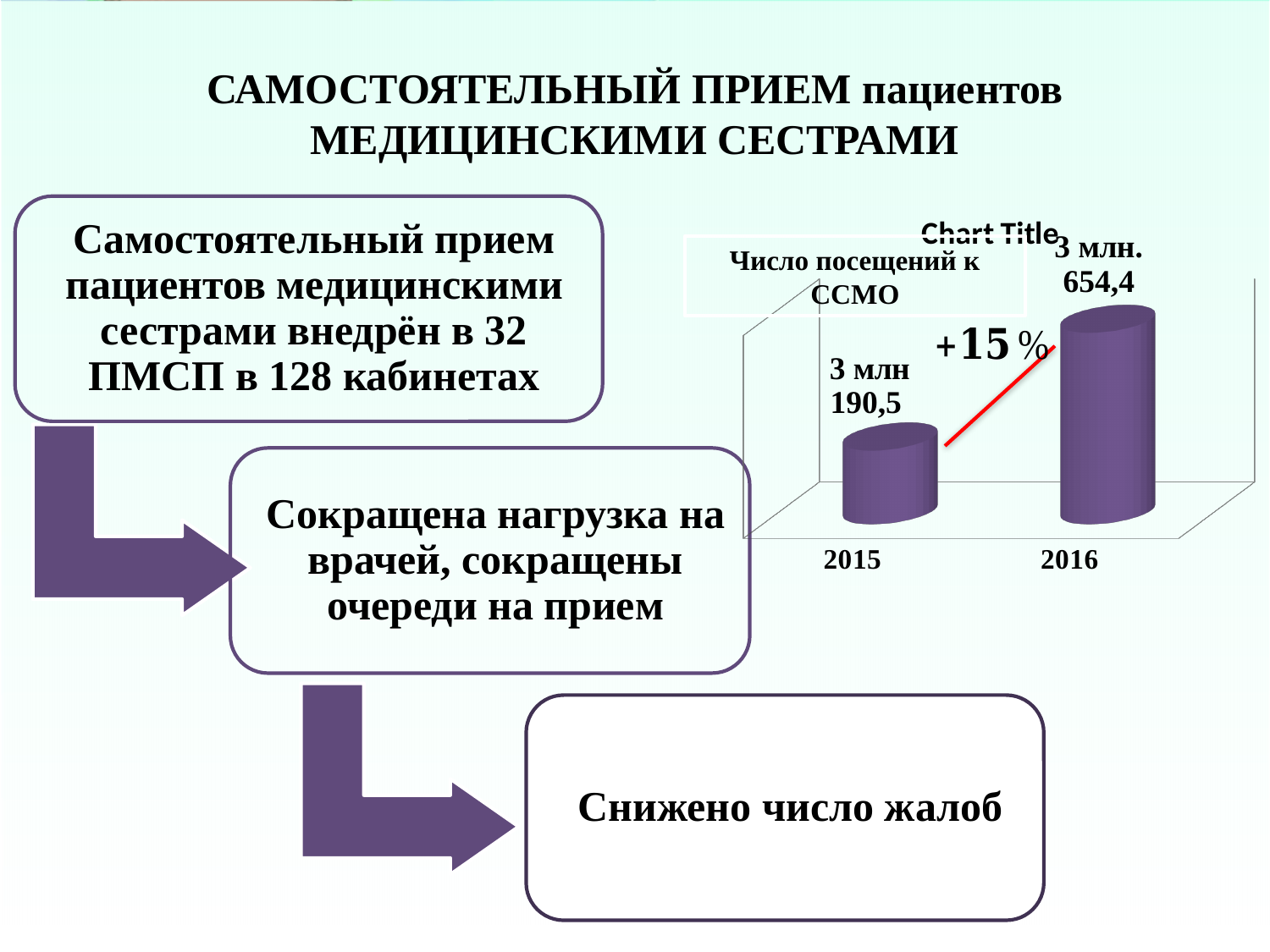
What series label is shown in the box at the top of the chart? Число посещений к ССМО Which year has the lower value in the chart? 2015 What value is shown for 2016 in the chart? 3 млн. 654,4 What value is shown for 2015 in the chart? 3 млн 190,5 What percentage change is annotated between the two bars in the chart? +15 % Is the value for 2016 larger or smaller than the value for 2015? larger Which year has the higher value in the chart? 2016 What kind of chart is shown on the slide? bar chart Do the values rise or fall from 2015 to 2016? rise How many categories (years) are plotted in the chart? 2